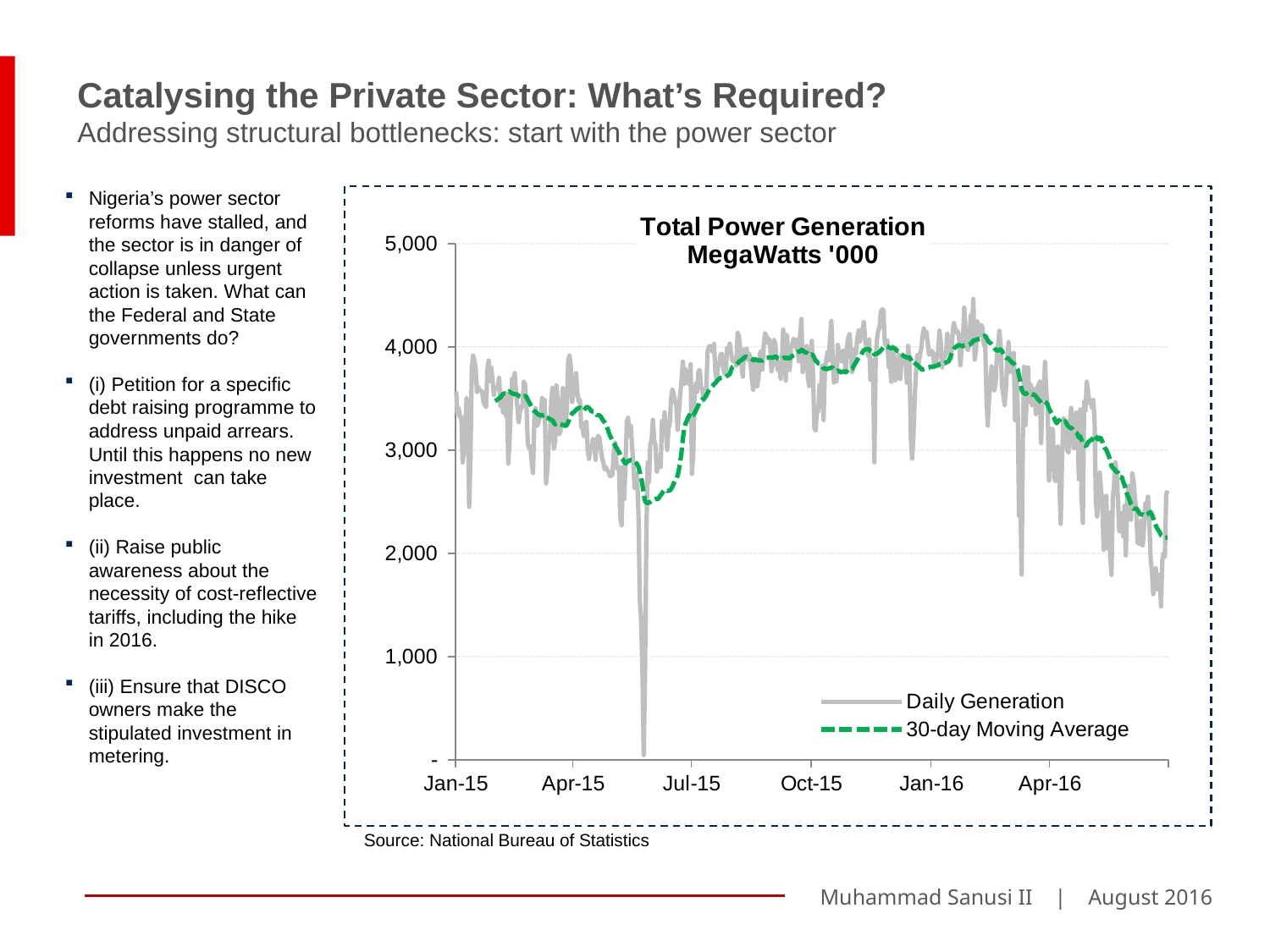
Is the 30-day Moving Average at the end of the series (after Apr-16) greater or less than 3,000? less Is the 30-day Moving Average at Apr-16 greater or less than 3,000? greater Is the 30-day Moving Average higher at Oct-15 or at Apr-16? Oct-15 Which series in the chart is drawn as a green dashed line? 30-day Moving Average Does the 30-day Moving Average rise or fall between Jan-16 and the end of the series? fall What is the title of the chart? Total Power Generation MegaWatts '000 How many series does the legend of the Total Power Generation chart list? 2 What kind of chart is shown on the slide? line chart Does the 30-day Moving Average rise or fall between Jul-15 and Oct-15? rise How many date labels are shown on the x axis of the chart? 6 Is the 30-day Moving Average at Oct-15 greater or less than 3,000? greater